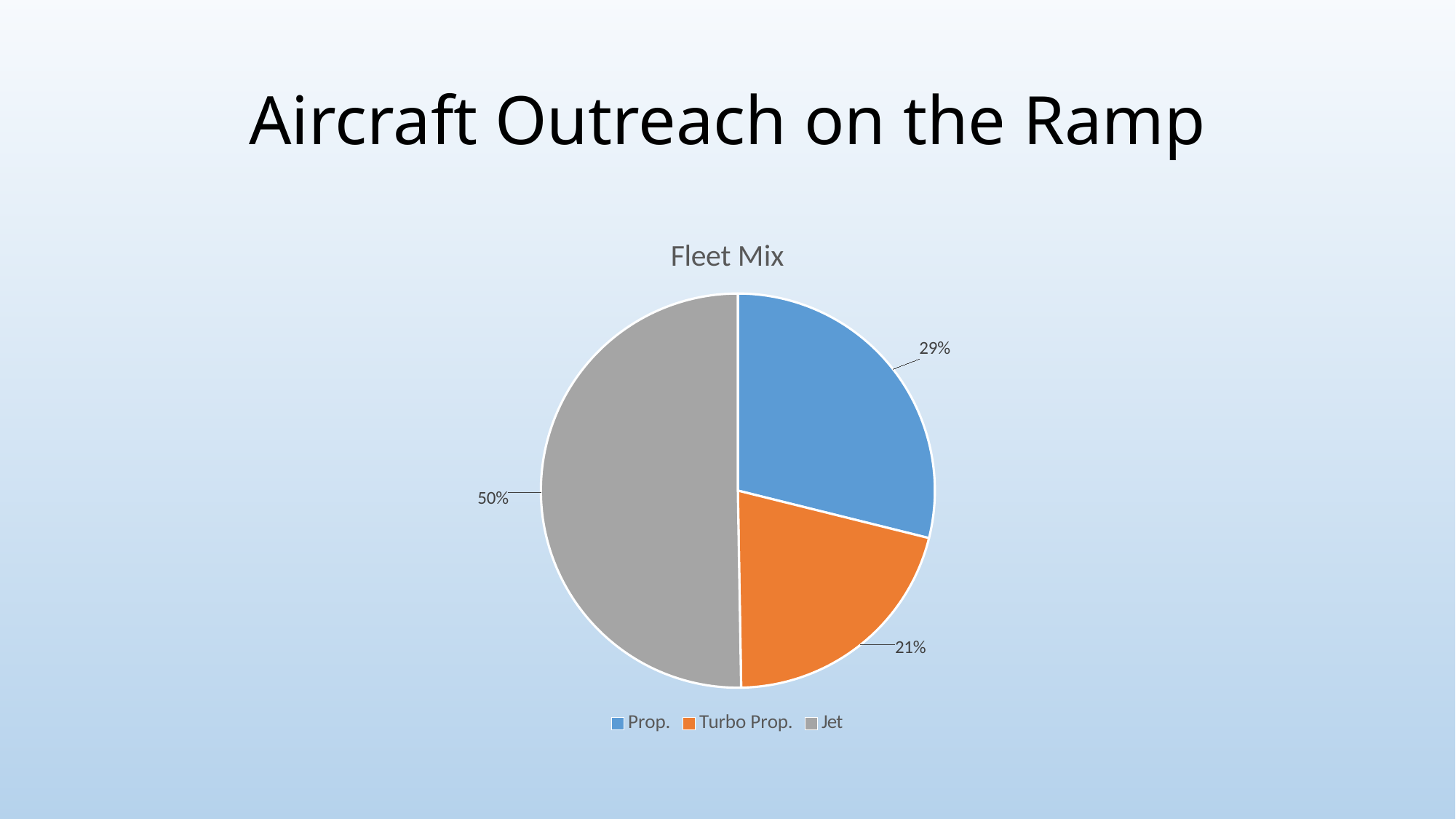
How many categories does the pie chart show? 3 What share of the pie does Prop. represent? 29% What share of the pie does Turbo Prop. represent? 21% How many entries does the legend list? 3 What is the title of the chart? Fleet Mix What type of chart is shown on the slide? pie chart What is the difference in percentage points between the Jet slice and the Prop. slice? 21% What colour is the Jet slice? grey Which is larger, the Prop. slice or the Turbo Prop. slice? Prop. Which category has the smallest slice of the pie? Turbo Prop. Which category has the largest slice of the pie? Jet What share of the pie does Jet represent? 50%